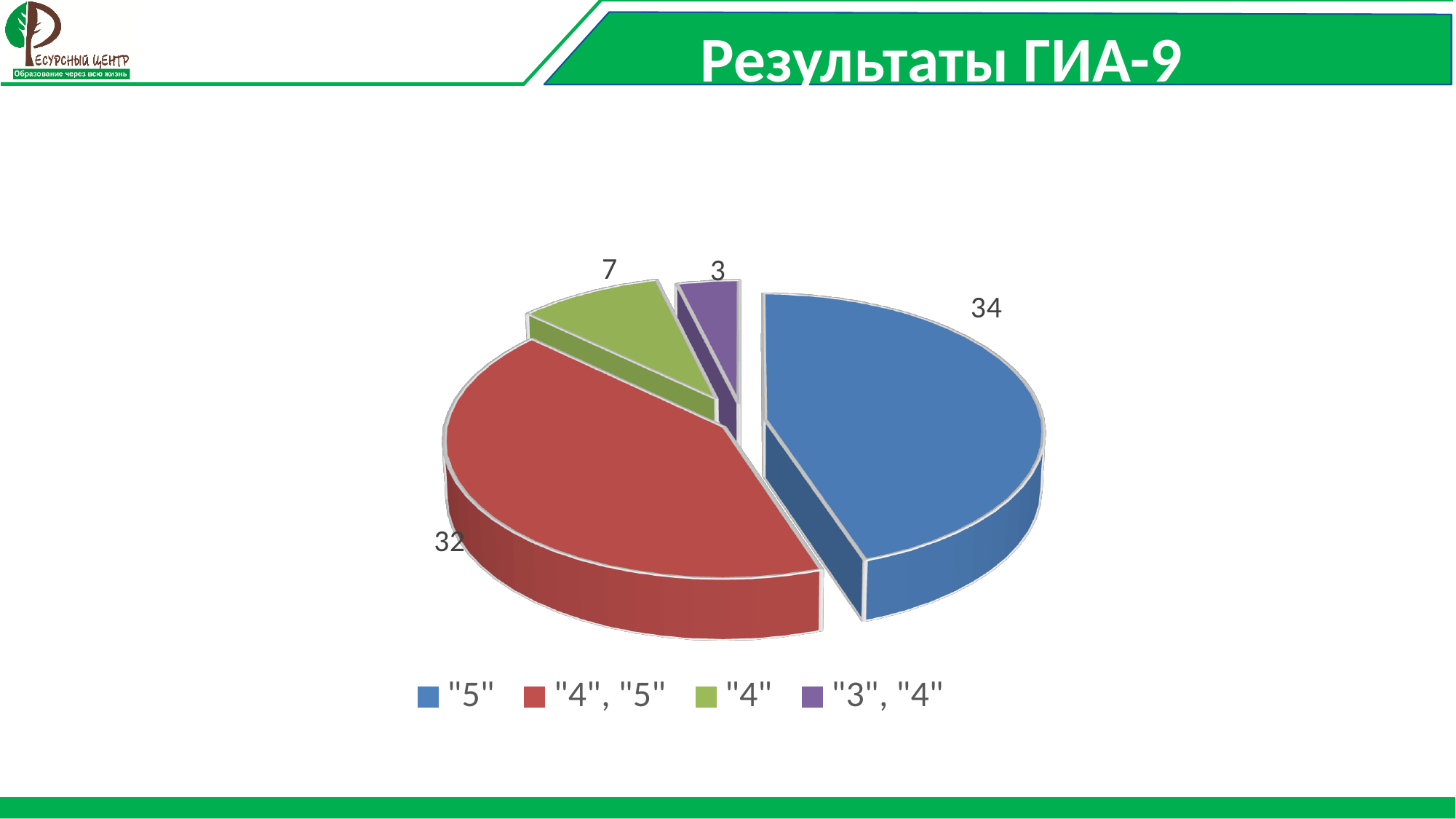
Which category has the smallest slice? "3", "4" Which is larger, the "4" slice or the "3", "4" slice? "4" Which category has the largest slice? "5" What type of chart is shown on the slide? pie chart What is the value of the "5" slice? 34 What is the total of all slice values in the pie chart? 76 What is the title of the slide containing the chart? Результаты ГИА-9 What is the difference between the "5" slice and the "4", "5" slice? 2 What is the value of the "4" slice? 7 What is the value of the "4", "5" slice? 32 What is the value of the "3", "4" slice? 3 How many slices does the pie chart have? 4